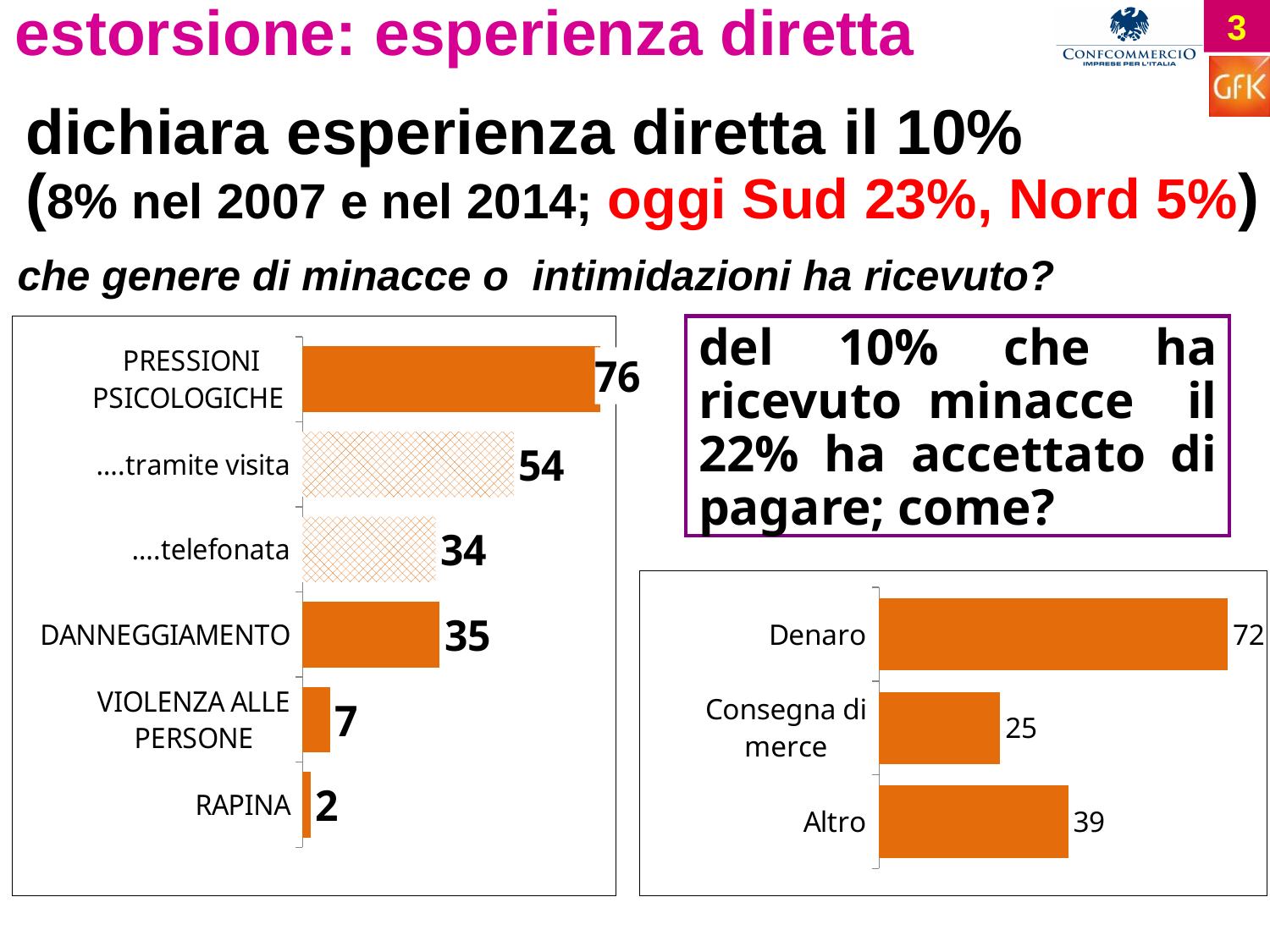
In the left chart, what is the value for DANNEGGIAMENTO? 35 In the left chart, what is the value for PRESSIONI PSICOLOGICHE? 76 In the left chart, what is the value for ....telefonata? 34 In the left chart, which category has the highest value? PRESSIONI PSICOLOGICHE In the left chart, what is the difference between ....tramite visita and ....telefonata? 20 In the right chart, what is the value for Consegna di merce? 25 In the left chart, how many categories are shown? 6 In the right chart, what is the difference between Denaro and Altro? 33 What type of chart is the right chart? Bar chart In the left chart, which category has the lowest value? RAPINA In the right chart, what is the value for Denaro? 72 In the right chart, which is larger, Altro or Consegna di merce? Altro